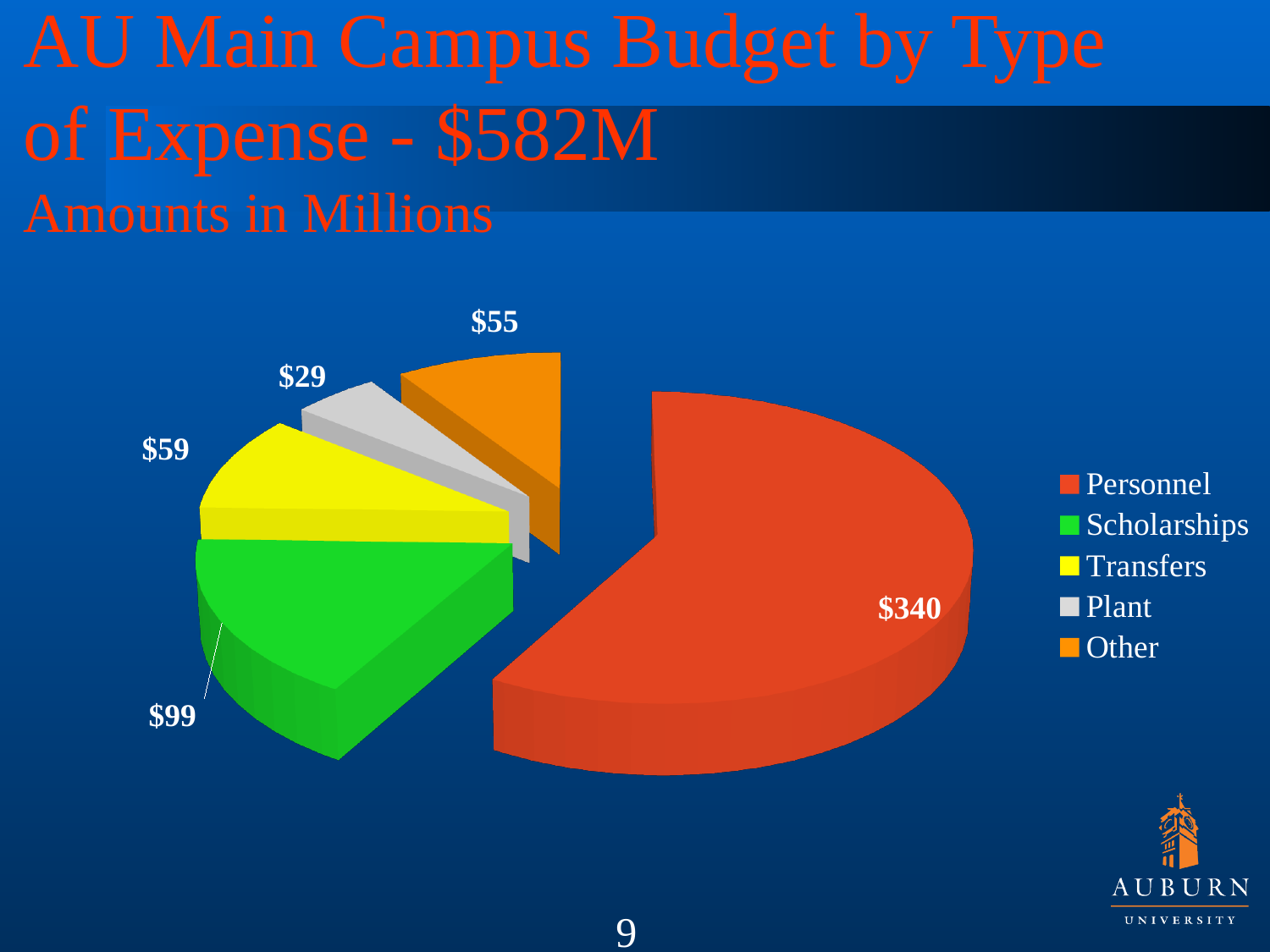
What is the value for Transfers? $59 What is the value for Personnel? $340 Which expense type has the largest slice of the pie? Personnel What is the value for Other? $55 Which expense type has the smallest slice of the pie? Plant Which is larger, the value for Transfers or the value for Other? Transfers What type of chart is shown on the slide? Pie chart What is the value for Scholarships? $99 What is the difference between the Personnel and Scholarships values? $241 To the nearest whole percent, what share of the total budget does Personnel represent? 58% How many expense categories does the legend list? 5 What is the value for Plant? $29